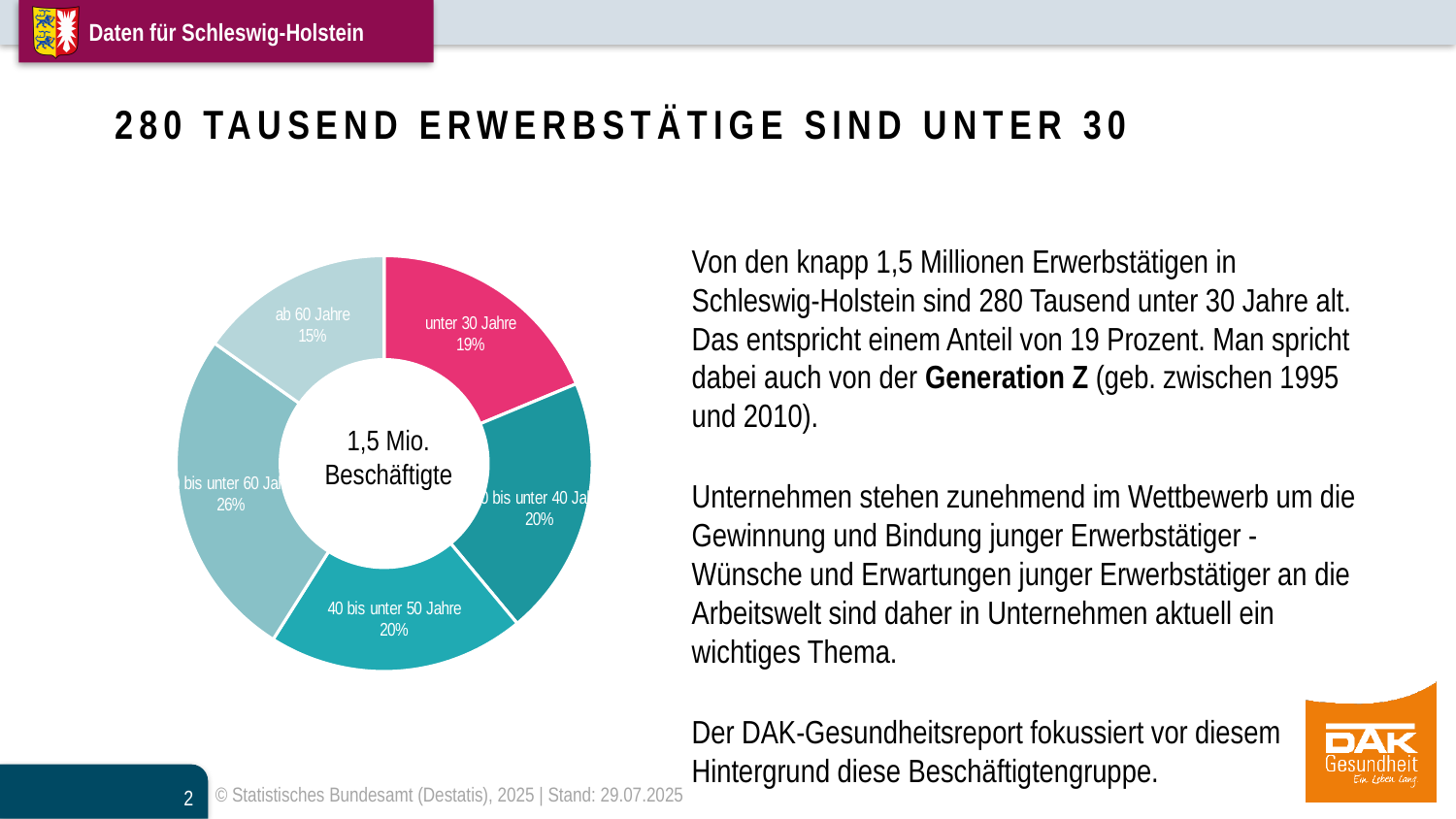
Which slice of the pie chart has the smallest share? ab 60 Jahre Which slice is larger, "40 bis unter 50 Jahre" or "unter 30 Jahre"? 40 bis unter 50 Jahre What is the difference in percentage points between the "unter 30 Jahre" slice and the "ab 60 Jahre" slice? 4 How many slices does the pie chart have? 5 Which slice is larger, "unter 30 Jahre" or "ab 60 Jahre"? unter 30 Jahre What share of the pie chart is labelled "ab 60 Jahre"? 15% What share of the pie chart is labelled "40 bis unter 50 Jahre"? 20% What kind of chart is shown on the slide? pie chart (donut) What colour is the "unter 30 Jahre" slice of the pie chart? pink What share of the pie chart is labelled "unter 30 Jahre"? 19% What text is shown in the centre of the donut chart? 1,5 Mio. Beschäftigte What is the largest percentage shown on any slice of the pie chart? 26%